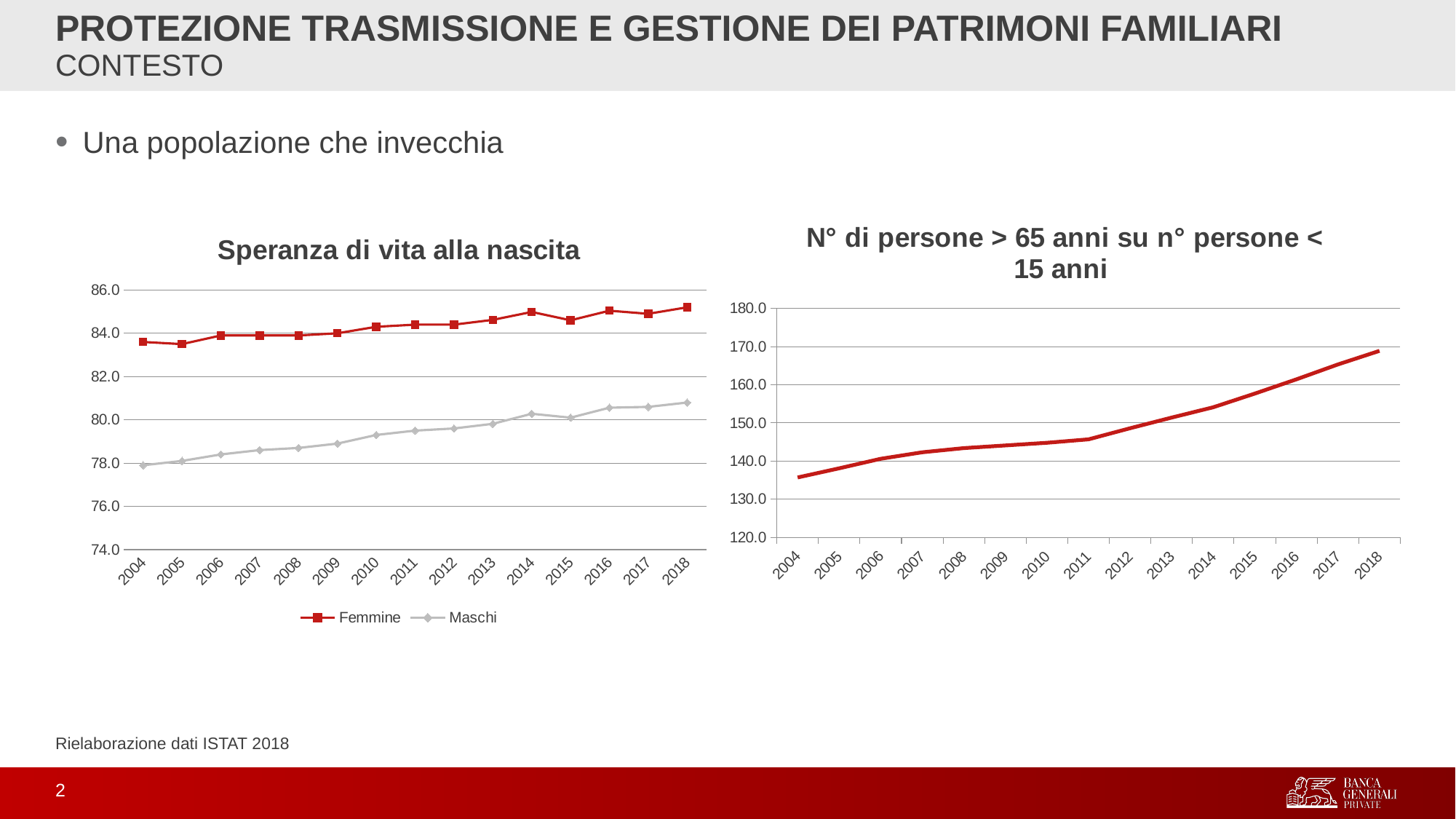
In the 'Speranza di vita alla nascita' chart, is the value for Maschi in 2010 greater or less than 80.0? less How many series does the legend of the 'Speranza di vita alla nascita' chart list? 2 What kind of chart is the 'Speranza di vita alla nascita' chart? line chart In the 'Speranza di vita alla nascita' chart, which series has the higher values across all years, Femmine or Maschi? Femmine In the 'N° di persone > 65 anni su n° persone < 15 anni' chart, is the value for 2018 greater or less than 160.0? greater In the 'N° di persone > 65 anni su n° persone < 15 anni' chart, is the value for 2004 greater or less than 130.0? greater What kind of chart is the 'N° di persone > 65 anni su n° persone < 15 anni' chart? line chart In the 'N° di persone > 65 anni su n° persone < 15 anni' chart, do the values rise or fall from 2004 to 2018? rise What are the two legend entries of the 'Speranza di vita alla nascita' chart? Femmine and Maschi How many years are plotted on the x axis of the 'Speranza di vita alla nascita' chart? 15